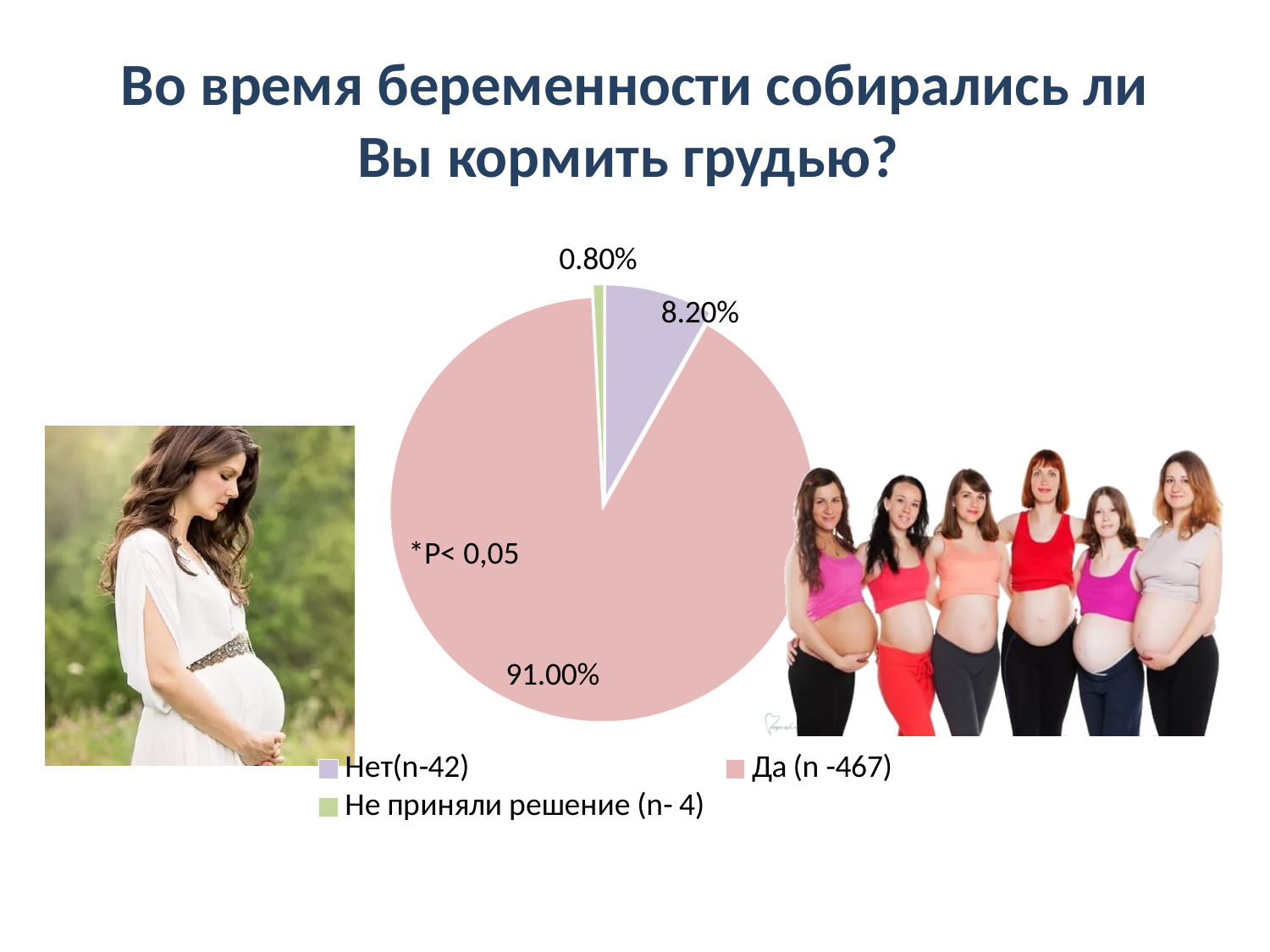
What is the difference in percentage points between the "Нет" slice and the "Не приняли решение" slice? 7.40% What kind of chart is shown on the slide? pie chart What statistical note is printed inside the pie chart? *P< 0,05 Which category has the smallest slice of the pie? Не приняли решение (n- 4) What share of the pie does the "Не приняли решение (n- 4)" slice represent? 0.80% What share of the pie does the "Да (n -467)" slice represent? 91.00% Which slice is larger, "Нет(n-42)" or "Не приняли решение (n- 4)"? Нет(n-42) What is the difference in percentage points between the "Да" slice and the "Нет" slice? 82.80% What is the title of the slide containing the chart? Во время беременности собирались ли Вы кормить грудью? What share of the pie does the "Нет(n-42)" slice represent? 8.20% Which category has the largest slice of the pie? Да (n -467) How many categories does the legend list? 3